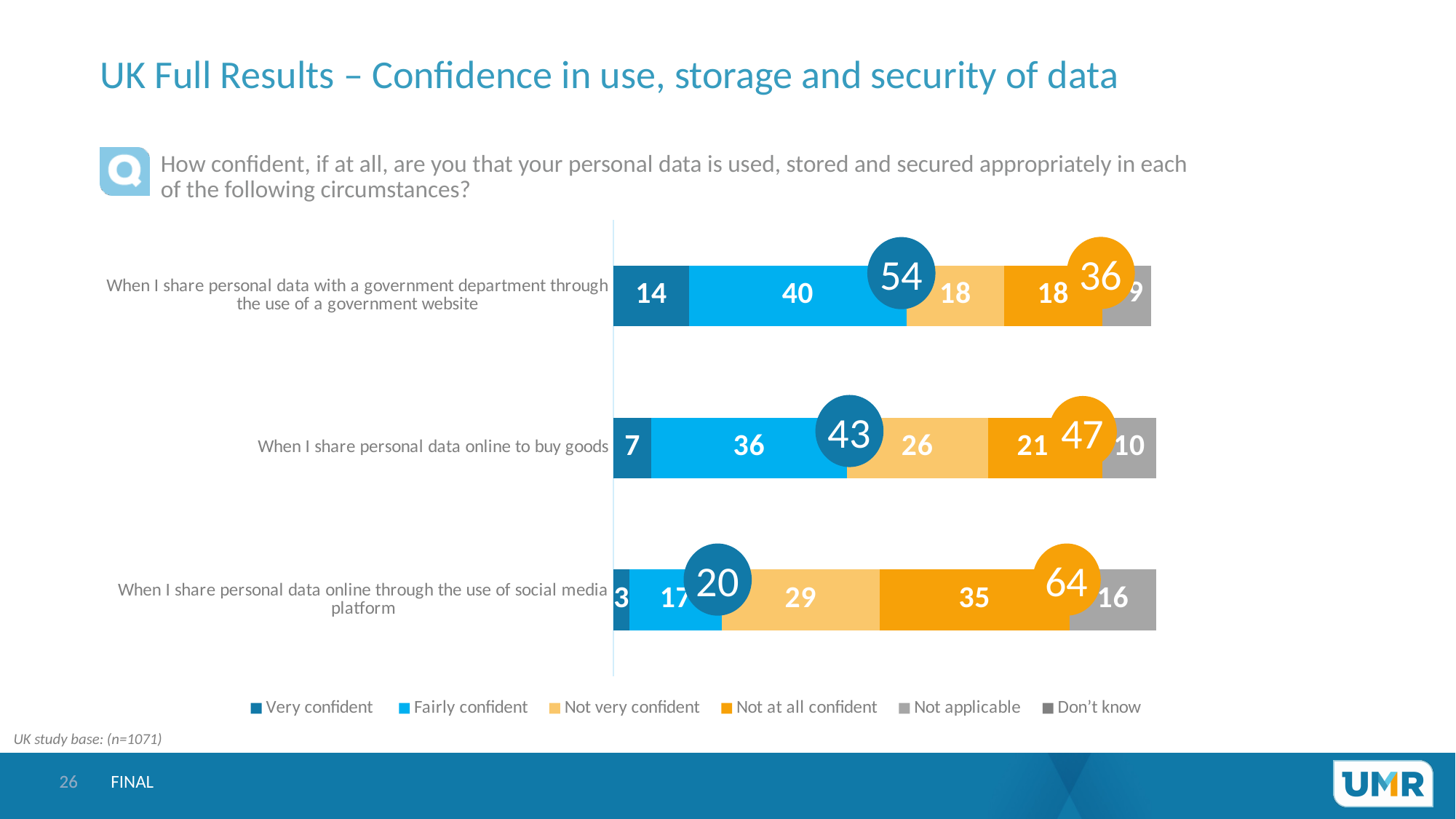
Which has the larger 'Not at all confident' value: sharing data online to buy goods or sharing data with a government department through a government website? When I share personal data online to buy goods What is the 'Very confident' value for sharing personal data with a government department through a government website? 14 What is the 'Fairly confident' value for sharing personal data online to buy goods? 36 What value is shown in the orange circle for sharing personal data online to buy goods? 47 What is the difference between the 'Not very confident' values for the social media platform (29) and the government website (18)? 11 How many circumstances (categories) are plotted in the chart? 3 What value is shown in the dark blue circle for sharing personal data online through the use of a social media platform? 20 What type of chart is shown on the slide? Bar chart What is the 'Not at all confident' value for sharing personal data online through the use of a social media platform? 35 How many series does the chart legend list? 6 Which circumstance has the lowest 'Very confident' value? When I share personal data online through the use of social media platform Which circumstance has the highest 'Very confident' value? When I share personal data with a government department through the use of a government website